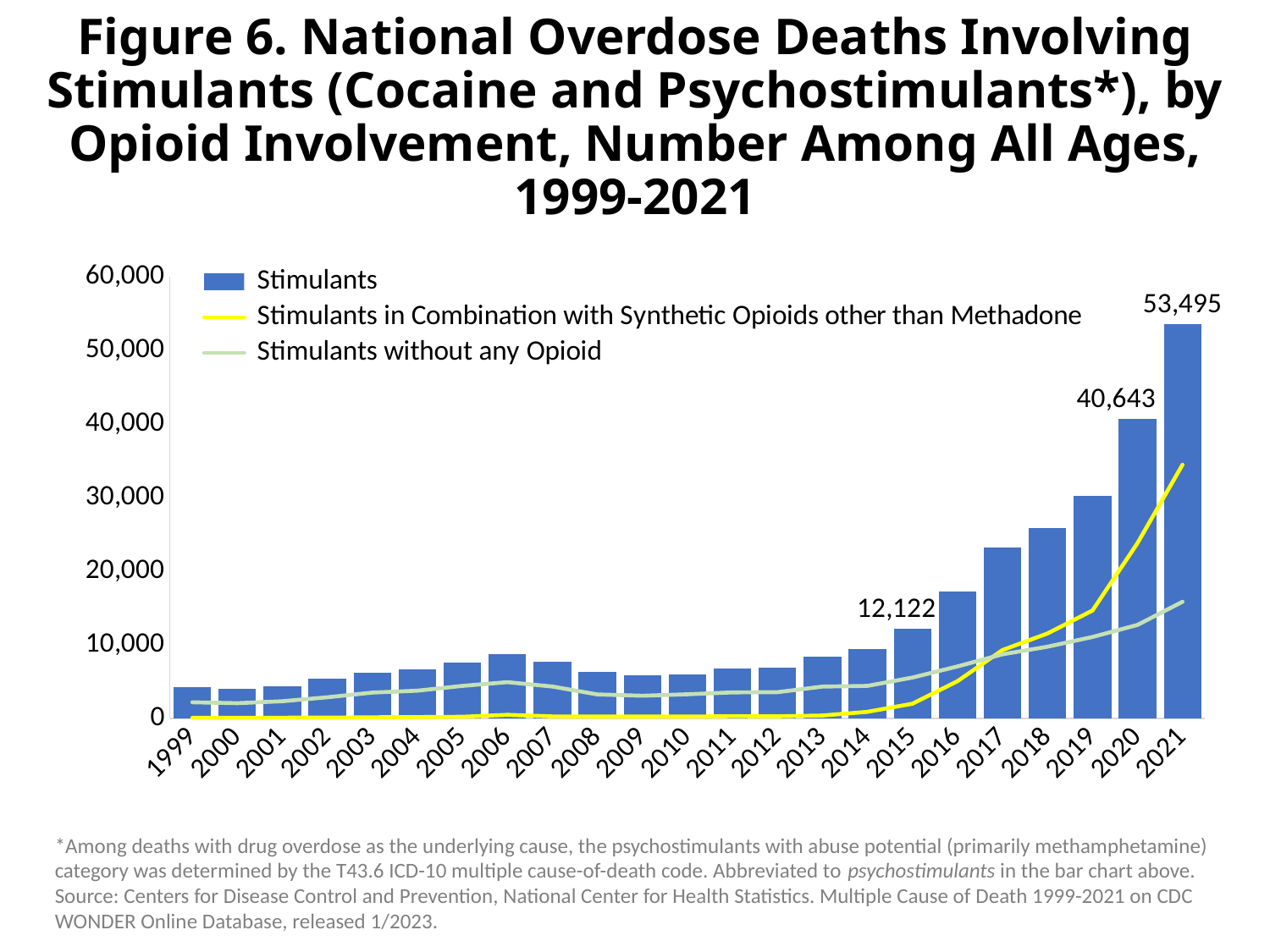
What is the number of overdose deaths involving stimulants in 2020? 40,643 Is the value of the Stimulants in Combination with Synthetic Opioids other than Methadone line in 2021 greater or less than 30,000? greater Which year has the highest number of overdose deaths involving stimulants? 2021 What is the difference between the stimulant overdose deaths in 2021 and 2020? 12,852 What is the number of overdose deaths involving stimulants in 2021? 53,495 How many years are shown on the x axis? 23 How many series does the legend list? 3 Which year has more stimulant overdose deaths, 2015 or 2020? 2020 What is the difference between the stimulant overdose deaths in 2020 and 2015? 28,521 Do the Stimulants bars rise or fall from 2015 to 2021? rise What is the number of overdose deaths involving stimulants in 2015? 12,122 Is the Stimulants bar for 2016 greater or less than 20,000? less